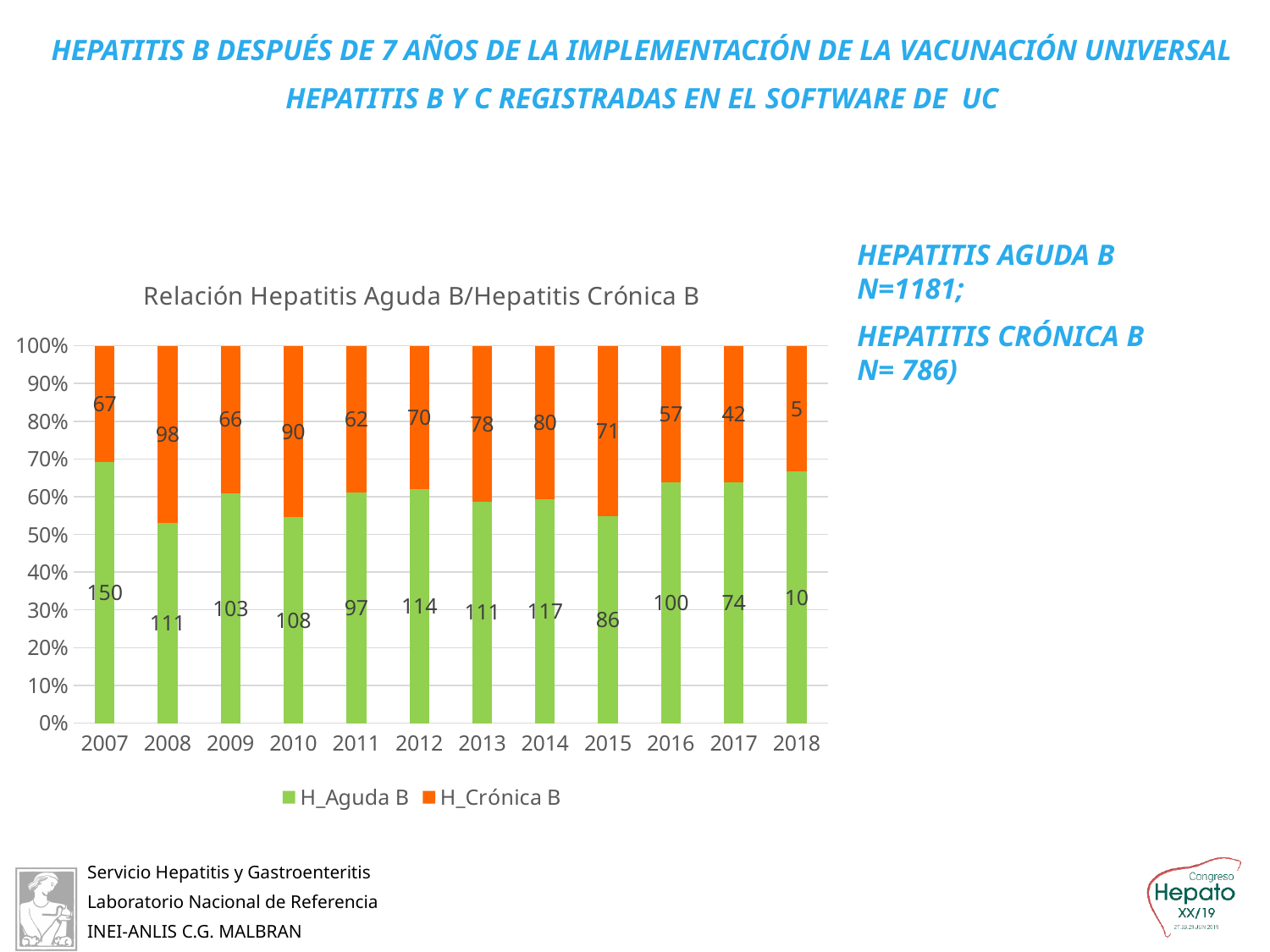
What is the value of H_Crónica B for 2018? 5 Which year has the lowest value for H_Crónica B? 2018 What is the value of H_Aguda B for 2015? 86 How many years are shown on the x axis of the chart? 12 Which year has the highest value for H_Aguda B? 2007 What is the difference between the H_Aguda B values for 2014 and 2017? 43 What is the combined count of H_Aguda B and H_Crónica B for 2007? 217 What is the value of H_Crónica B for 2010? 90 Which is larger, the H_Crónica B value for 2008 or for 2013? 2008 What is the value of H_Aguda B for 2007? 150 How many series does the legend list? 2 What type of chart is shown on the slide? Stacked bar chart